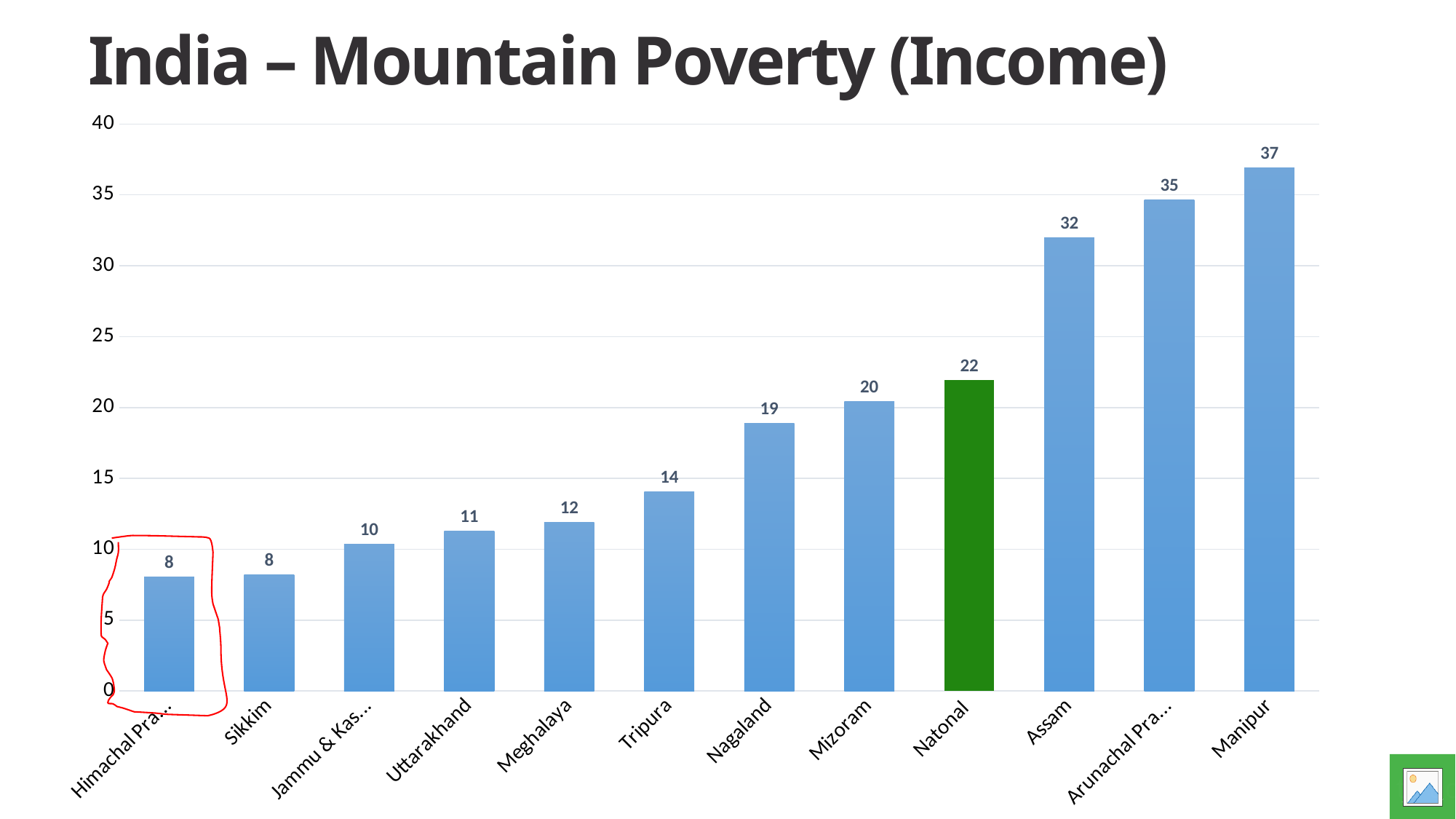
Which is larger, the value for Tripura or the value for Meghalaya? Tripura What is the lowest value shown on the chart? 8 What is the value for Uttarakhand? 11 What is the value for the Natonal bar? 22 Is the value for Assam greater or less than 30? greater Which category has the highest value? Manipur Which bar is coloured green instead of blue? Natonal What kind of chart is shown on the slide? Bar chart What is the difference between the values for Assam and Mizoram? 12 What is the value for Nagaland? 19 What is the value for Manipur? 37 How many bars are shown on the chart? 12